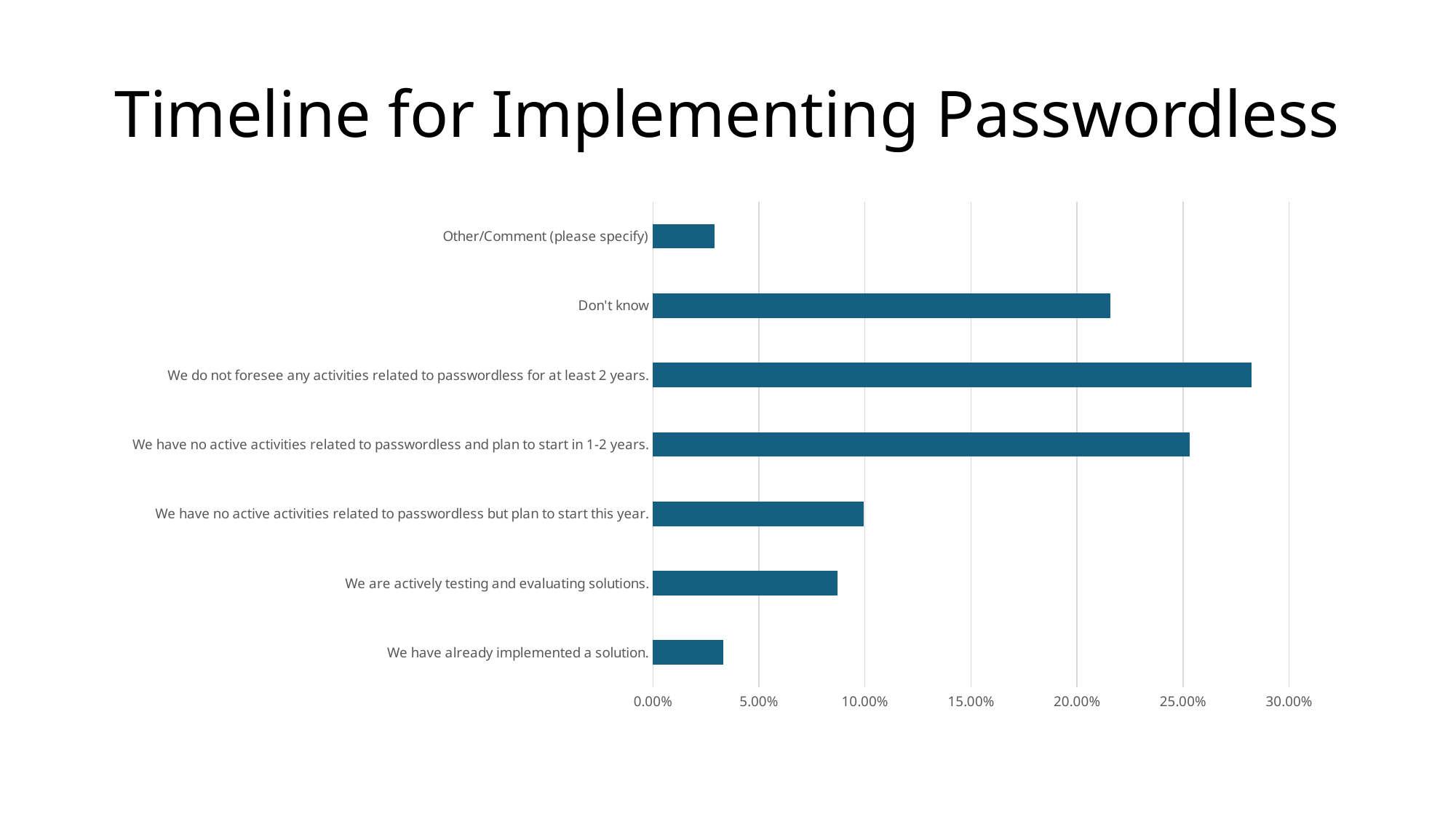
What is the title of the chart on the slide? Timeline for Implementing Passwordless Is the value for "We are actively testing and evaluating solutions." greater or less than 10.00%? less Is the value for "We have no active activities related to passwordless and plan to start in 1-2 years." greater or less than 30.00%? less How many categories are plotted in the chart? 7 What kind of chart is shown on the slide? bar chart Is the value for "We do not foresee any activities related to passwordless for at least 2 years." greater or less than 25.00%? greater Which is larger: the value for "Don't know" or the value for "We have no active activities related to passwordless but plan to start this year."? Don't know Which is larger: the value for "We are actively testing and evaluating solutions." or the value for "We have already implemented a solution."? We are actively testing and evaluating solutions. Which category has the highest value in the chart? We do not foresee any activities related to passwordless for at least 2 years.